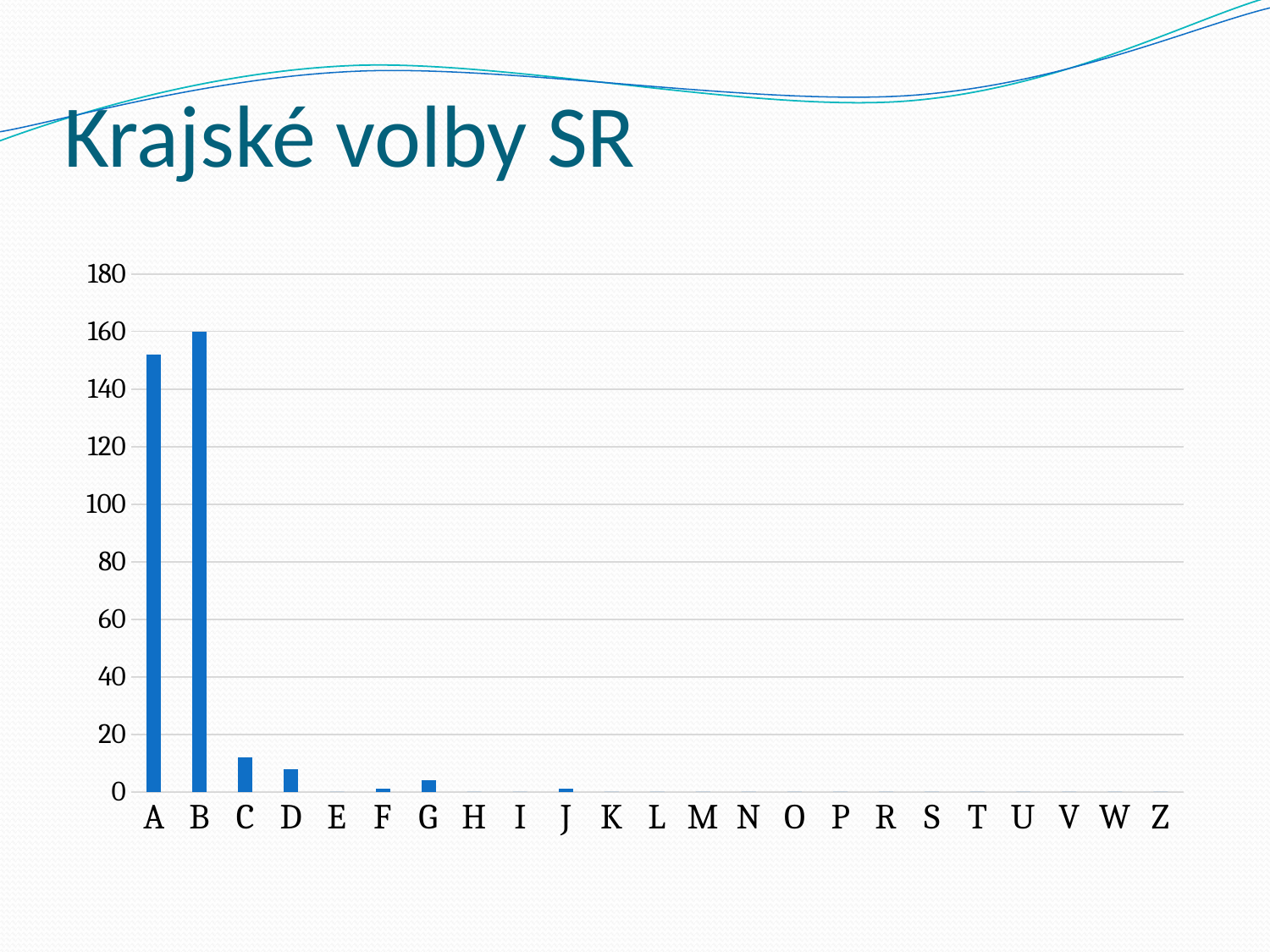
Which has the larger value, C or D? C What kind of chart is shown on the slide? bar chart Is the value for A greater or less than 160? less Is the value for D greater or less than 20? less What is the highest value shown on the y axis of the chart? 180 Is the value for A greater or less than 140? greater Which category has the highest value in the chart? B How many categories are shown on the x axis of the chart? 23 What is the title of the slide? Krajské volby SR What is the value for category B? 160 Which has the larger value, A or B? B